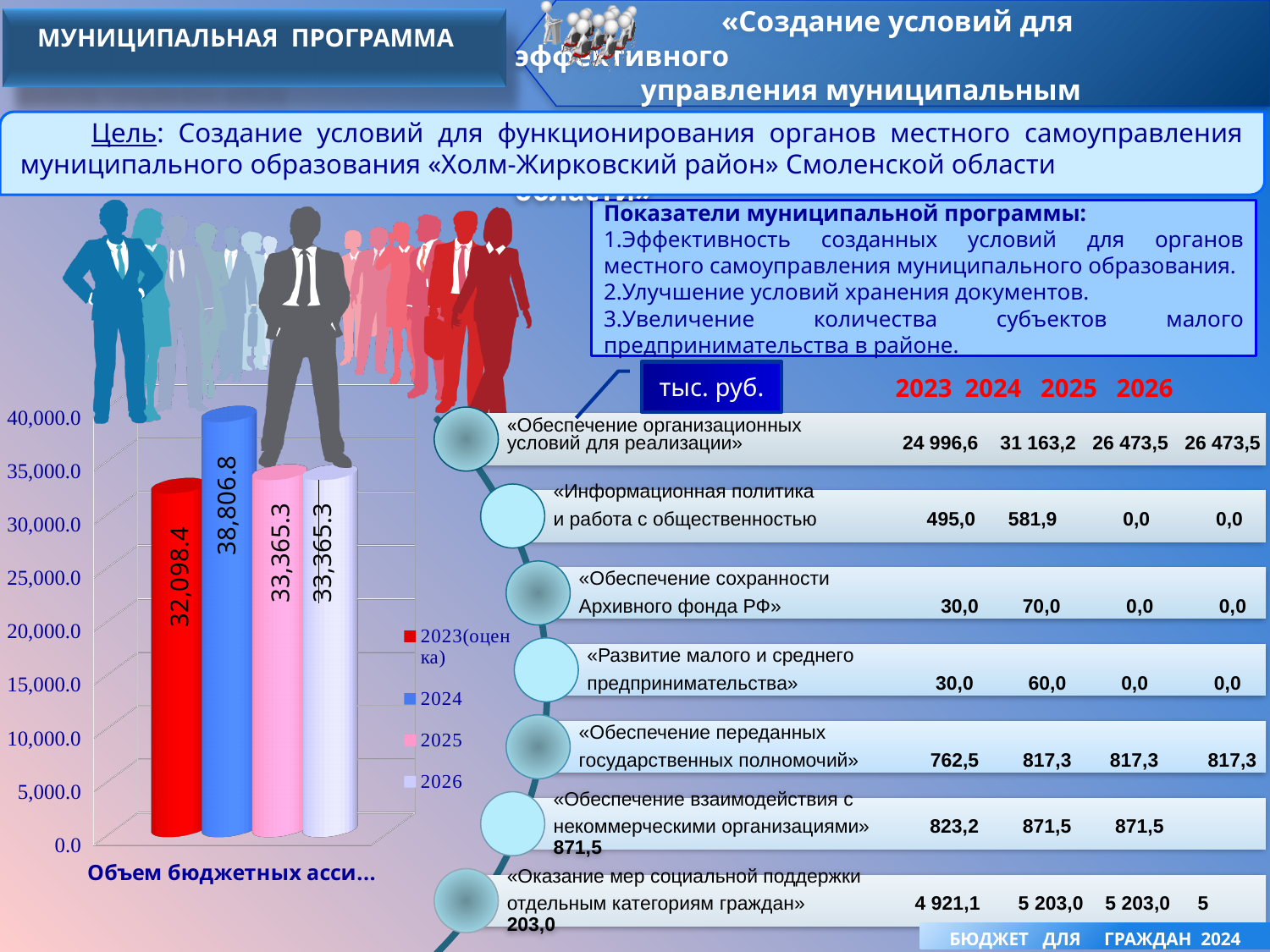
What type of chart is shown on the slide? bar chart How many bars are plotted in the chart? 4 What is the difference between the 2024 value and the 2023(оценка) value in the chart? 6,708.4 Is the value for 2023(оценка) greater or less than 30,000.0? greater Which year has the highest bar in the chart? 2024 What is the value of the 2023(оценка) bar in the chart? 32,098.4 Which year has the lowest bar in the chart? 2023(оценка) What is the value of the 2024 bar in the chart? 38,806.8 What colour is the 2024 bar in the chart? blue How many entries does the chart legend list? 4 Which is larger in the chart, the 2024 value or the 2025 value? 2024 What is the value of the 2025 bar in the chart? 33,365.3